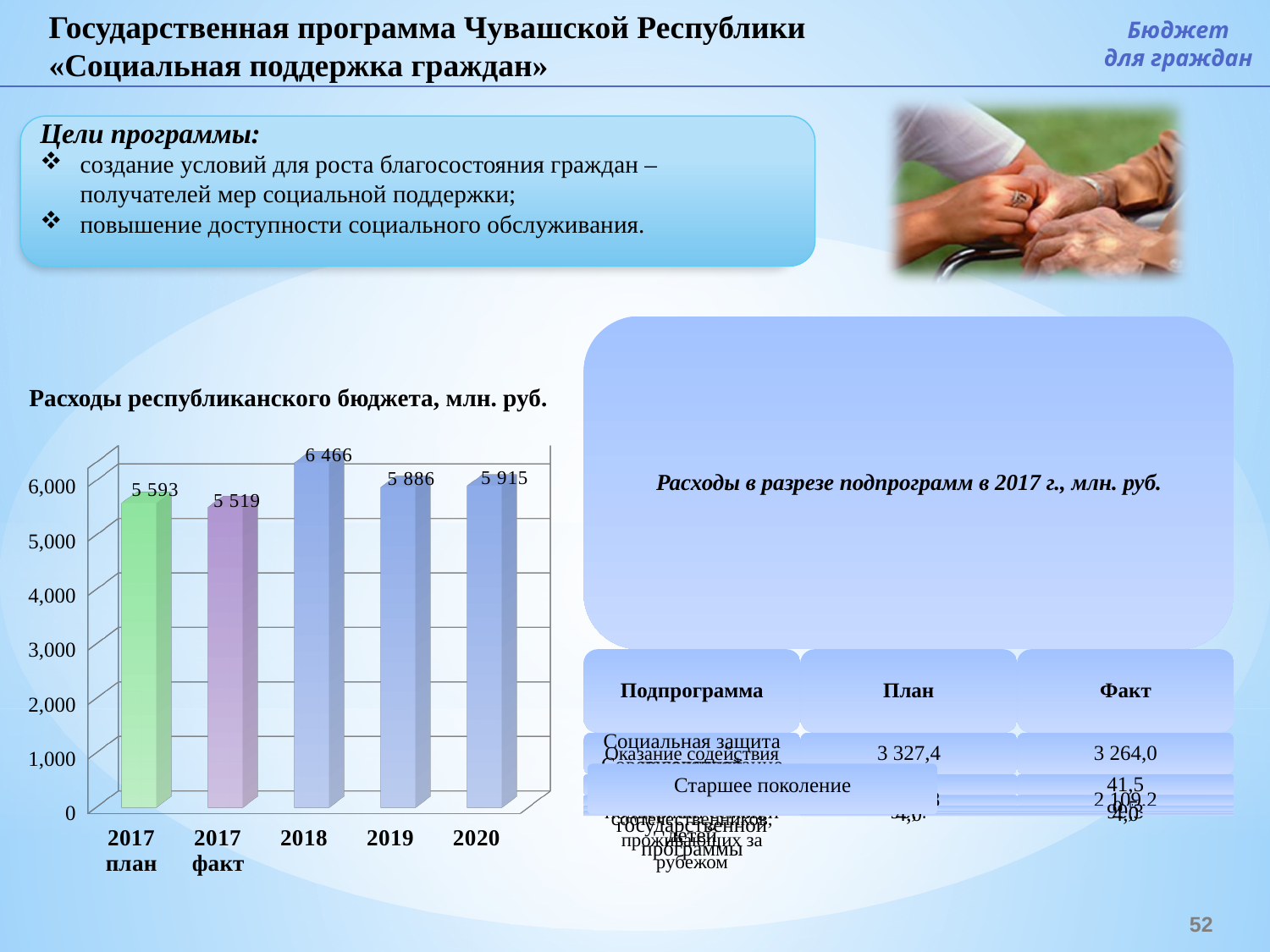
What is the value for 2017 план in the chart 'Расходы республиканского бюджета, млн. руб.'? 5 593 Which category has the lowest value in the chart 'Расходы республиканского бюджета, млн. руб.'? 2017 факт What is the value for 2020 in the chart 'Расходы республиканского бюджета, млн. руб.'? 5 915 What is the difference between the 2017 план and 2017 факт values in the chart 'Расходы республиканского бюджета, млн. руб.'? 74 In the chart 'Расходы республиканского бюджета, млн. руб.', is the value for 2019 greater or less than 5,000? greater What is the value for 2018 in the chart 'Расходы республиканского бюджета, млн. руб.'? 6 466 Which category has the highest value in the chart 'Расходы республиканского бюджета, млн. руб.'? 2018 How many bars are shown in the chart 'Расходы республиканского бюджета, млн. руб.'? 5 In the chart 'Расходы республиканского бюджета, млн. руб.', which is larger: the value for 2019 or the value for 2018? 2018 What is the value for 2017 факт in the chart 'Расходы республиканского бюджета, млн. руб.'? 5 519 What type of chart is 'Расходы республиканского бюджета, млн. руб.'? bar chart What is the title of the bar chart on the left of the slide? Расходы республиканского бюджета, млн. руб.